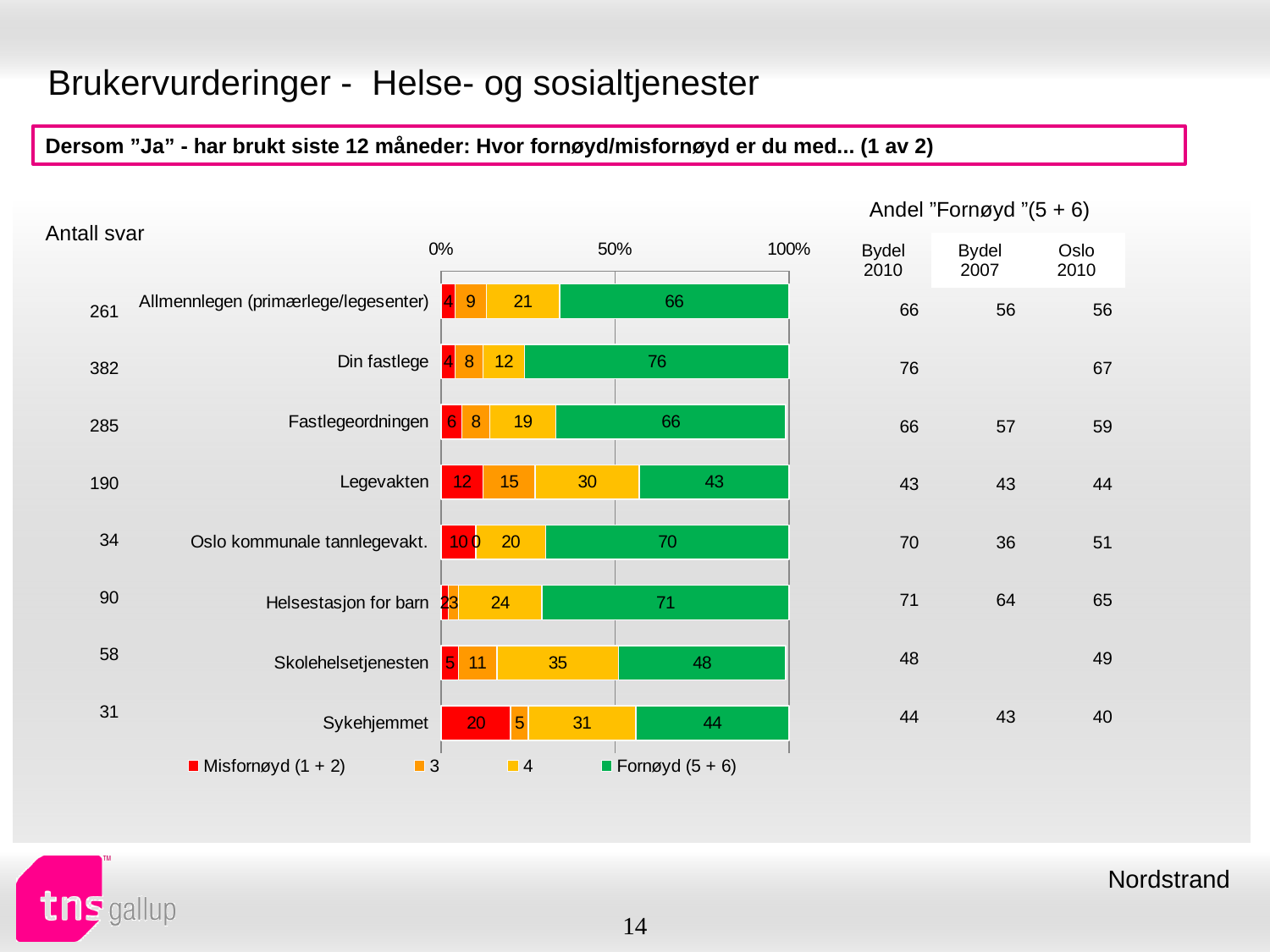
What is the value of Misfornøyd (1 + 2) for Legevakten? 12 Which category has the highest Fornøyd (5 + 6) value? Din fastlege Which has a larger Fornøyd (5 + 6) value, Skolehelsetjenesten or Sykehjemmet? Skolehelsetjenesten How many categories are shown in the bar chart? 8 What is the value of Misfornøyd (1 + 2) for Sykehjemmet? 20 How many series does the chart legend list? 4 What is the difference between the Fornøyd (5 + 6) values for Din fastlege and Legevakten? 33 Which category has the highest Misfornøyd (1 + 2) value? Sykehjemmet Which category has the lowest Fornøyd (5 + 6) value? Legevakten What kind of chart is shown on the slide? Stacked bar chart What is the value of Fornøyd (5 + 6) for Din fastlege? 76 What is the value of the '4' series for Skolehelsetjenesten? 35